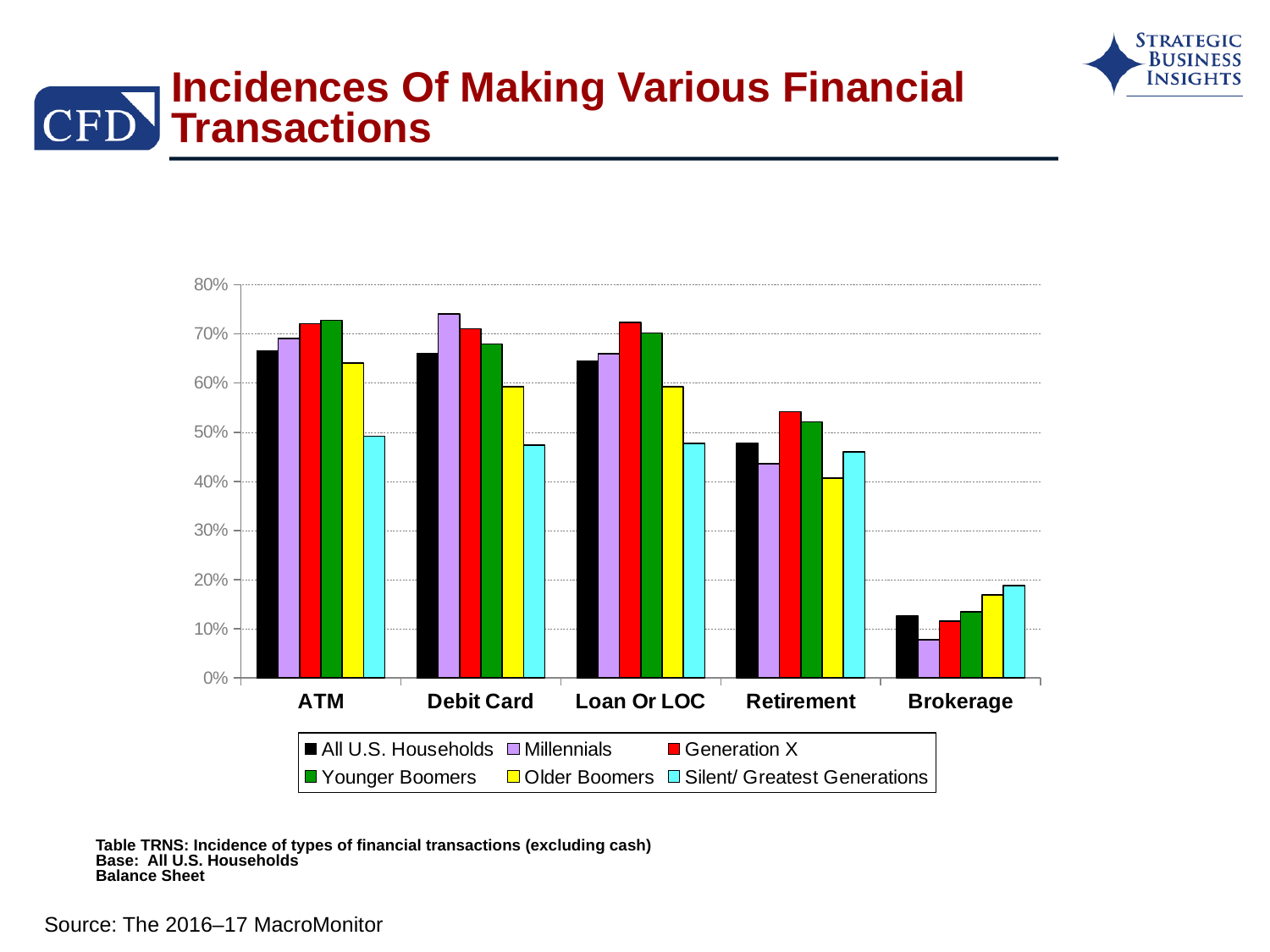
Is the value for Millennials in the Debit Card category greater or less than 70%? greater Which transaction category has the lowest incidence for All U.S. Households? Brokerage In the Loan Or LOC category, which series has the lowest value? Silent/ Greatest Generations In the Debit Card category, which is larger: Millennials or Silent/ Greatest Generations? Millennials What kind of chart is shown on the slide? Bar chart How many transaction categories are shown on the x axis? 5 In the Brokerage category, which series has the lowest value? Millennials In the Brokerage category, which series has the highest value? Silent/ Greatest Generations Is the value for Silent/ Greatest Generations in the ATM category greater or less than 60%? less How many series does the legend list? 6 Is the value for Millennials in the Brokerage category greater or less than 10%? less What colour represents Generation X in the legend? Red